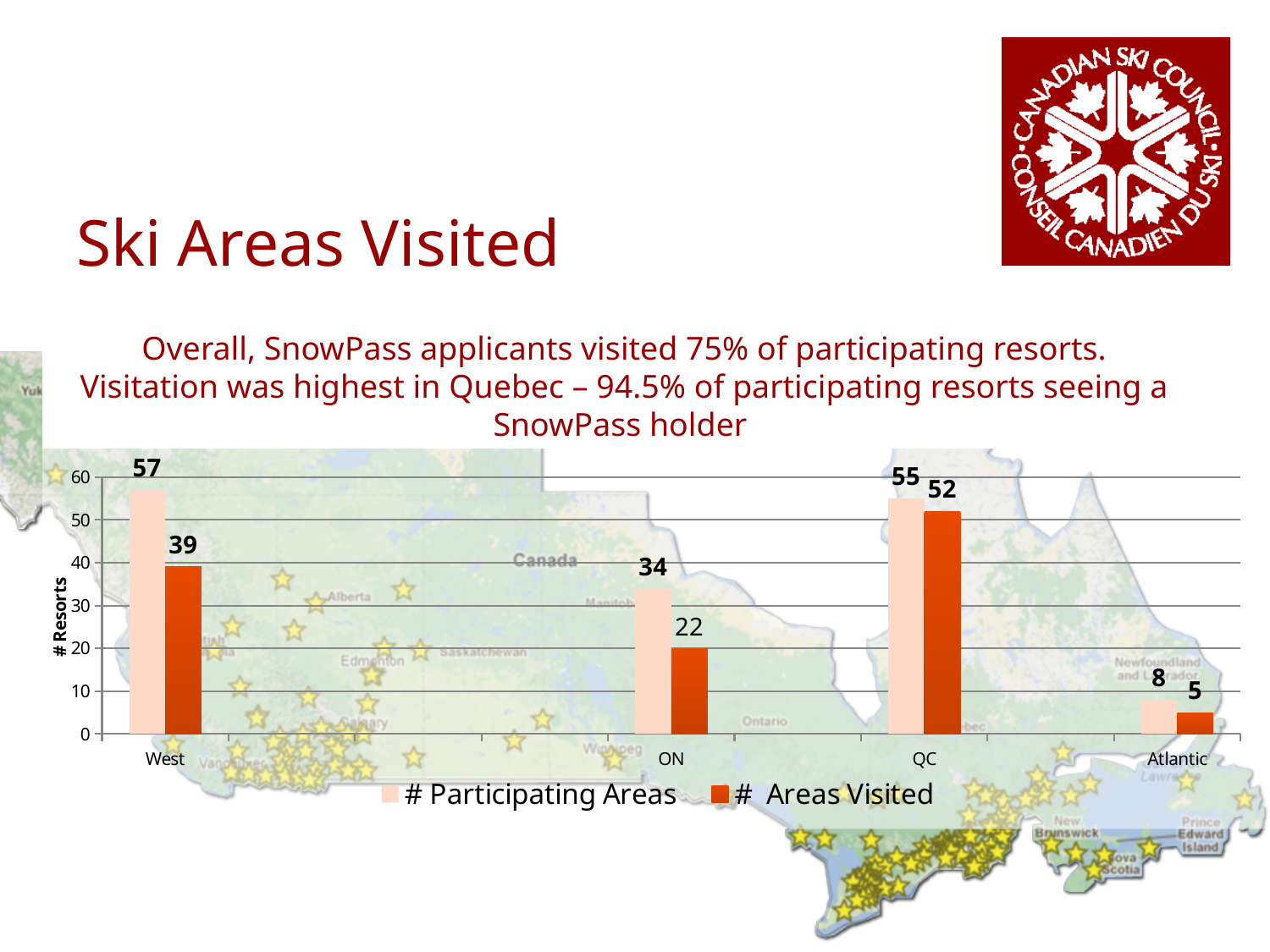
Which region has the lowest number of participating areas? Atlantic How many series does the chart legend list? 2 What kind of chart is shown on the slide? Bar chart How many regions are shown on the x axis of the chart? 4 What is the label of the vertical axis of the chart? # Resorts What is the number of participating areas for the West region? 57 What is the number of areas visited for QC? 52 What is the number of areas visited for ON? 22 Which is larger: the number of areas visited in ON or the number of areas visited in West? West Which region has the highest number of areas visited? QC What is the difference between the number of participating areas and the number of areas visited for the West region? 18 What is the number of participating areas for Atlantic? 8